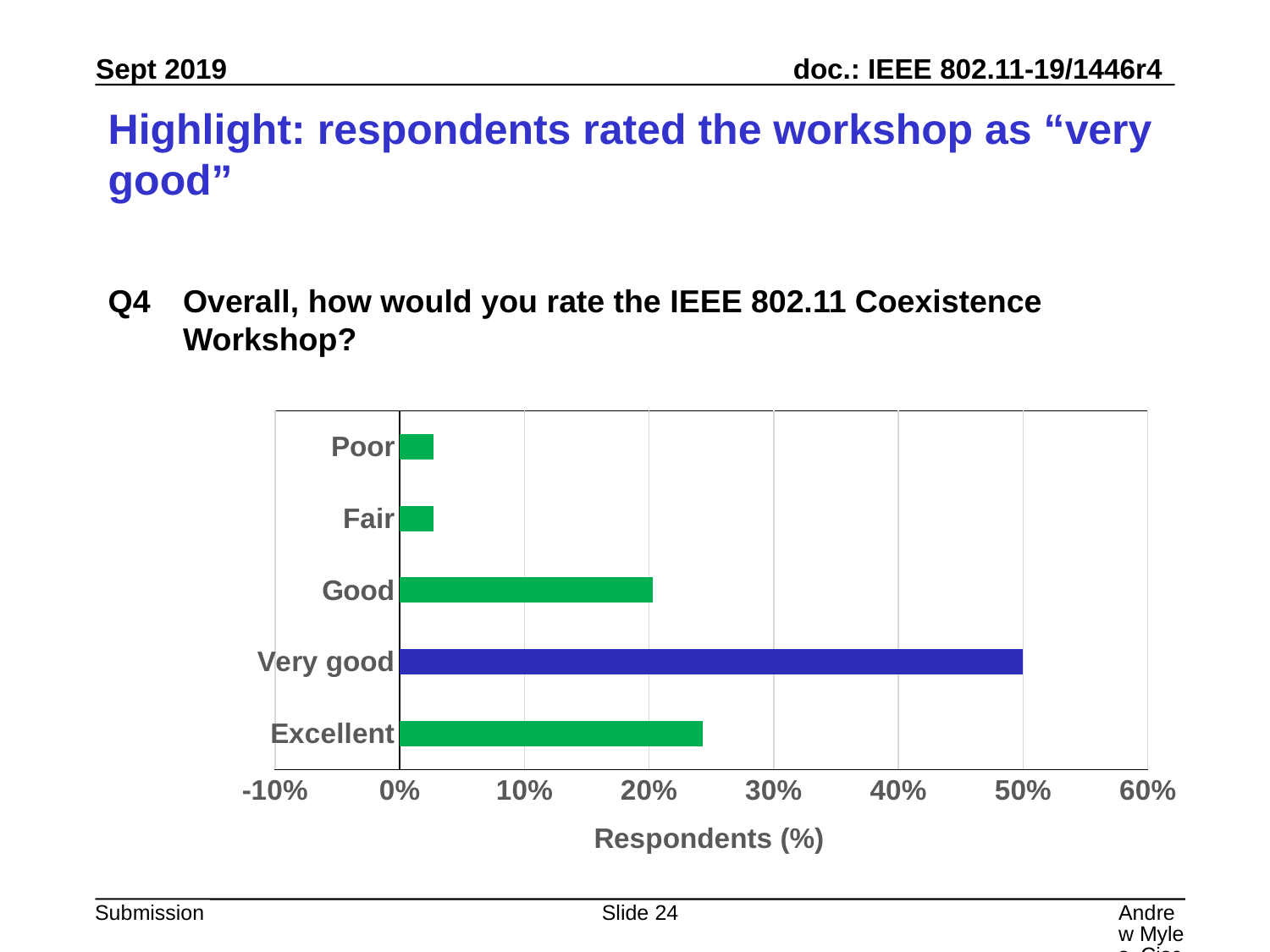
Is the value for "Fair" greater or less than 10%? less What is the title of the horizontal axis of the chart? Respondents (%) What percentage of respondents rated the workshop as "Very good"? 50% Which rating category has the highest percentage of respondents? Very good Which has a larger share of respondents, "Excellent" or "Good"? Excellent Is the value for "Poor" greater or less than 10%? less How many rating categories are plotted in the chart? 5 Is the value for "Excellent" greater or less than 20%? greater What kind of chart is shown on the slide? bar chart Which bar in the chart is coloured blue rather than green? Very good Which has a larger share of respondents, "Very good" or "Excellent"? Very good